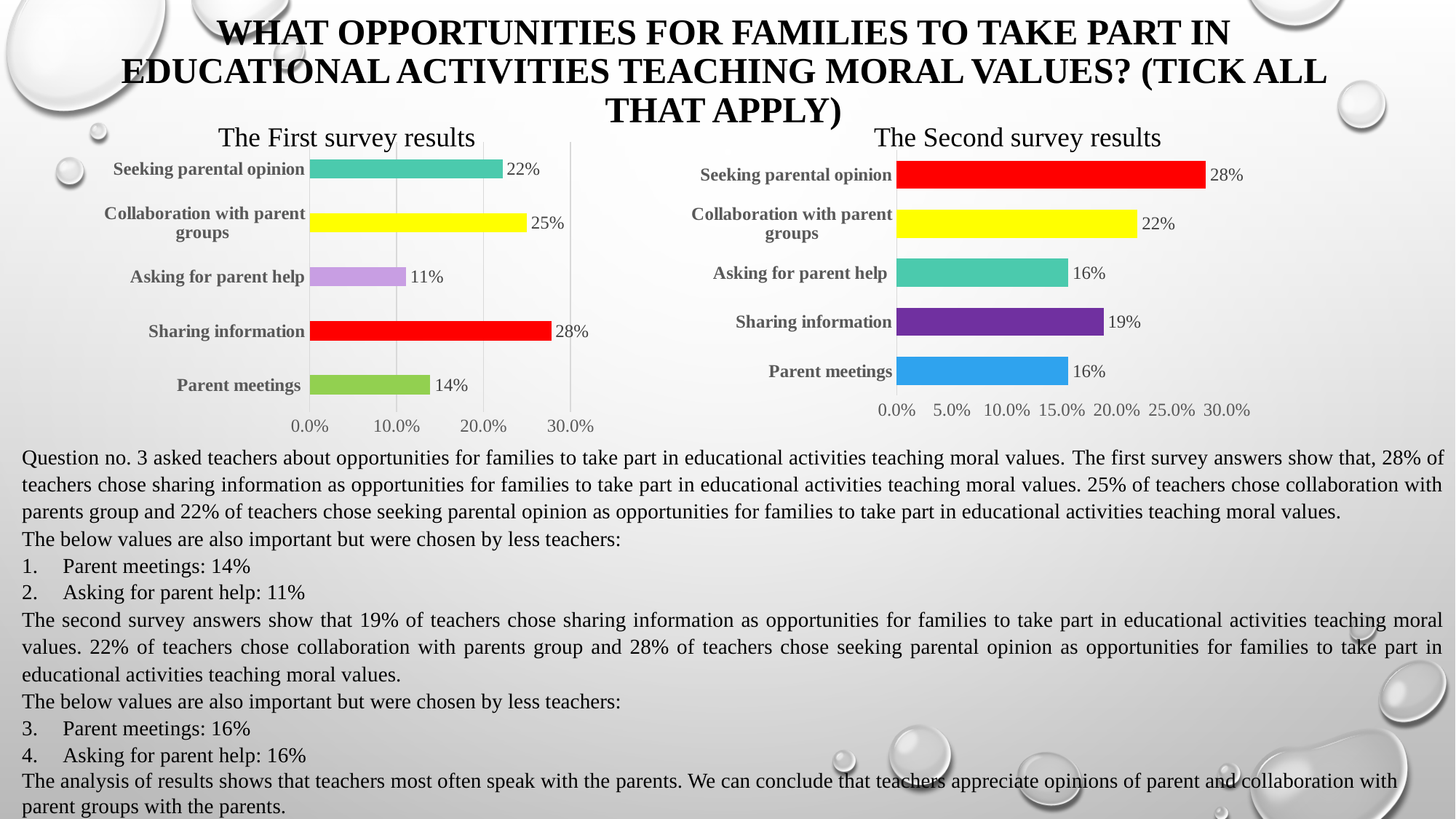
What kind of chart is 'The Second survey results'? Bar chart How many categories are shown in the chart titled 'The First survey results'? 5 In the chart titled 'The Second survey results', what is the value for Seeking parental opinion? 28% In the chart titled 'The Second survey results', which category has the highest value? Seeking parental opinion In the chart titled 'The Second survey results', what colour is the bar for Parent meetings? Blue In the chart titled 'The Second survey results', is the value for Sharing information greater or less than 20.0%? less In the chart titled 'The First survey results', what is the value for Sharing information? 28% In the chart titled 'The First survey results', what is the difference between Sharing information and Parent meetings? 14% In the chart titled 'The First survey results', which is larger: Collaboration with parent groups or Seeking parental opinion? Collaboration with parent groups In the chart titled 'The Second survey results', what is the difference between Collaboration with parent groups and Sharing information? 3% In the chart titled 'The First survey results', what is the value for Asking for parent help? 11% In the chart titled 'The First survey results', which category has the lowest value? Asking for parent help